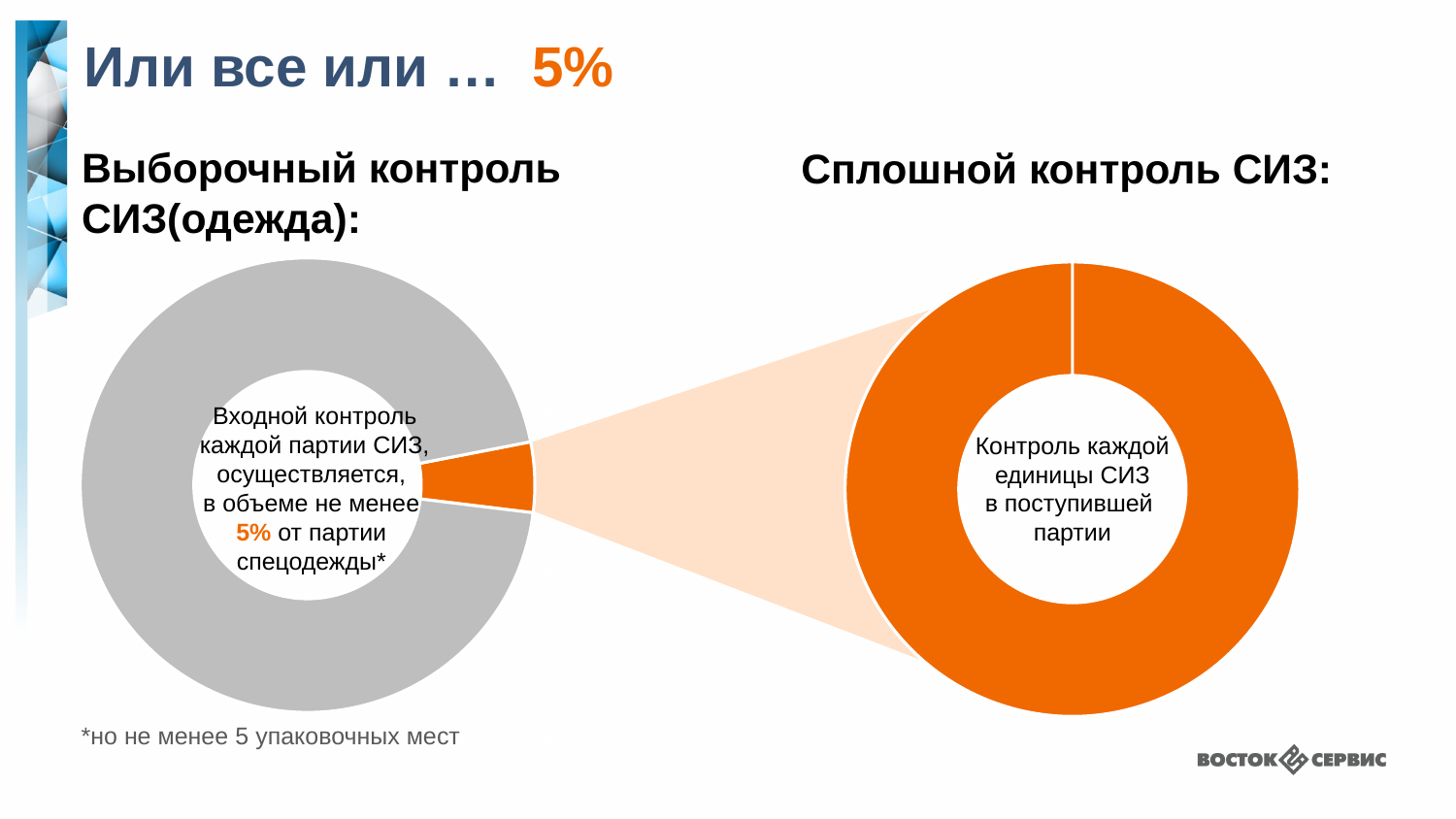
In the left chart ("Выборочный контроль СИЗ(одежда):"), which slice is larger, the grey one or the orange one? the grey one How many slices does the right chart ("Сплошной контроль СИЗ:") have? 1 What percentage is highlighted in orange in the slide title "Или все или …"? 5% In the left chart ("Выборочный контроль СИЗ(одежда):"), is the orange slice's share greater or less than 50%? less What kind of chart is shown on the left under "Выборочный контроль СИЗ(одежда):"? donut (pie) chart According to the footnote under the left chart, what is the minimum number of packing units to be checked? 5 упаковочных мест In the left chart ("Выборочный контроль СИЗ(одежда):"), what share of the batch does the orange slice represent? 5% What is the heading above the right donut chart? Сплошной контроль СИЗ: What is the heading above the left donut chart? Выборочный контроль СИЗ(одежда): How many slices does the left chart ("Выборочный контроль СИЗ(одежда):") have? 2